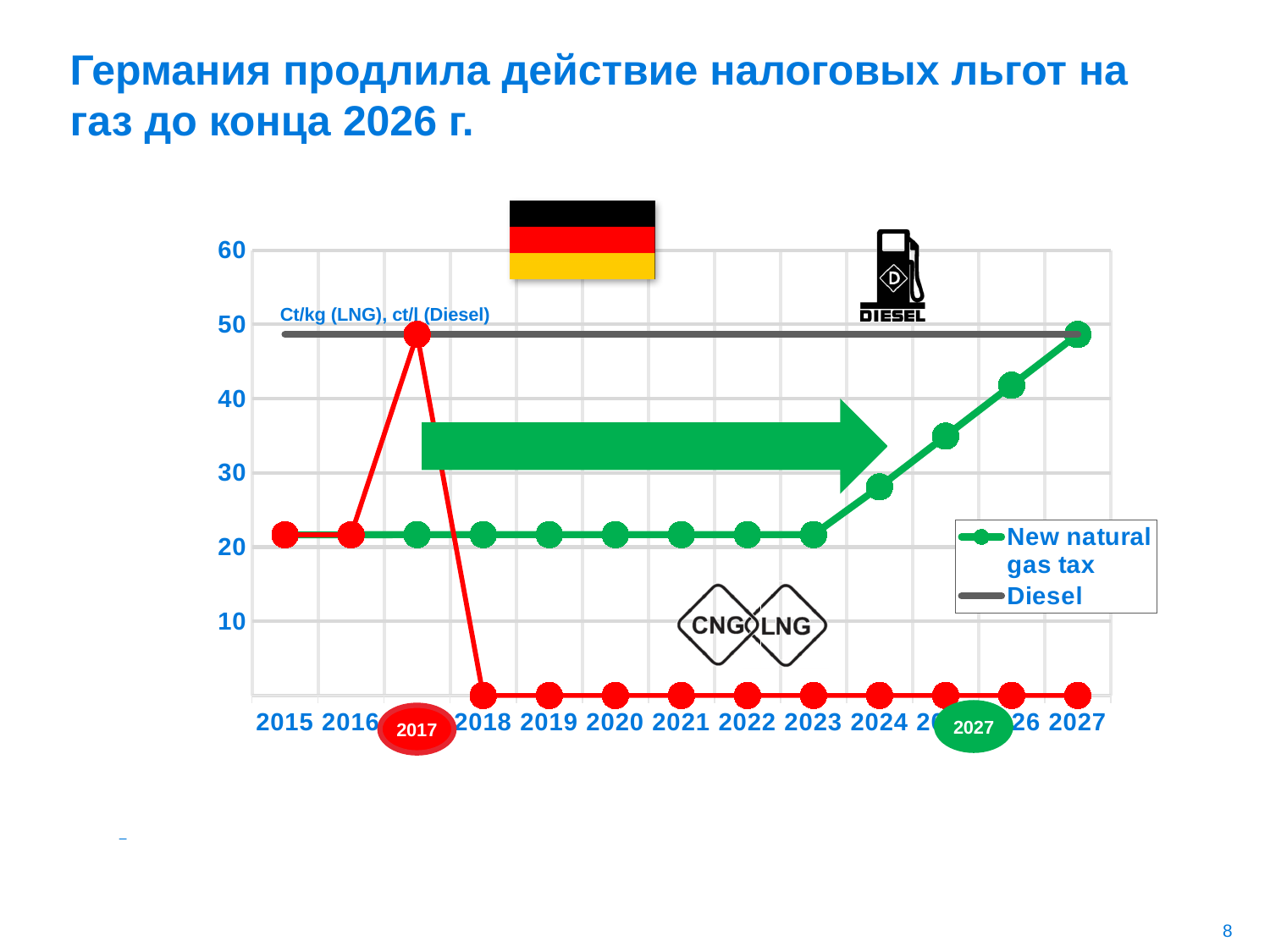
Is the value for New natural gas tax in 2027 greater or less than 40? greater What kind of chart is shown on the slide? line chart How many series does the chart legend list? 2 In which year does the New natural gas tax series reach its highest value? 2027 Which is larger for New natural gas tax: the value in 2024 or the value in 2020? 2024 Is the value for New natural gas tax in 2025 greater or less than 30? greater In 2021, which series has the larger value: Diesel or New natural gas tax? Diesel Does the New natural gas tax line rise or fall from 2023 to 2027? rise How many years are shown on the x axis of the chart? 13 Is the Diesel value greater or less than 40? greater What unit label is printed at the top of the chart's y axis? Ct/kg (LNG), ct/l (Diesel)